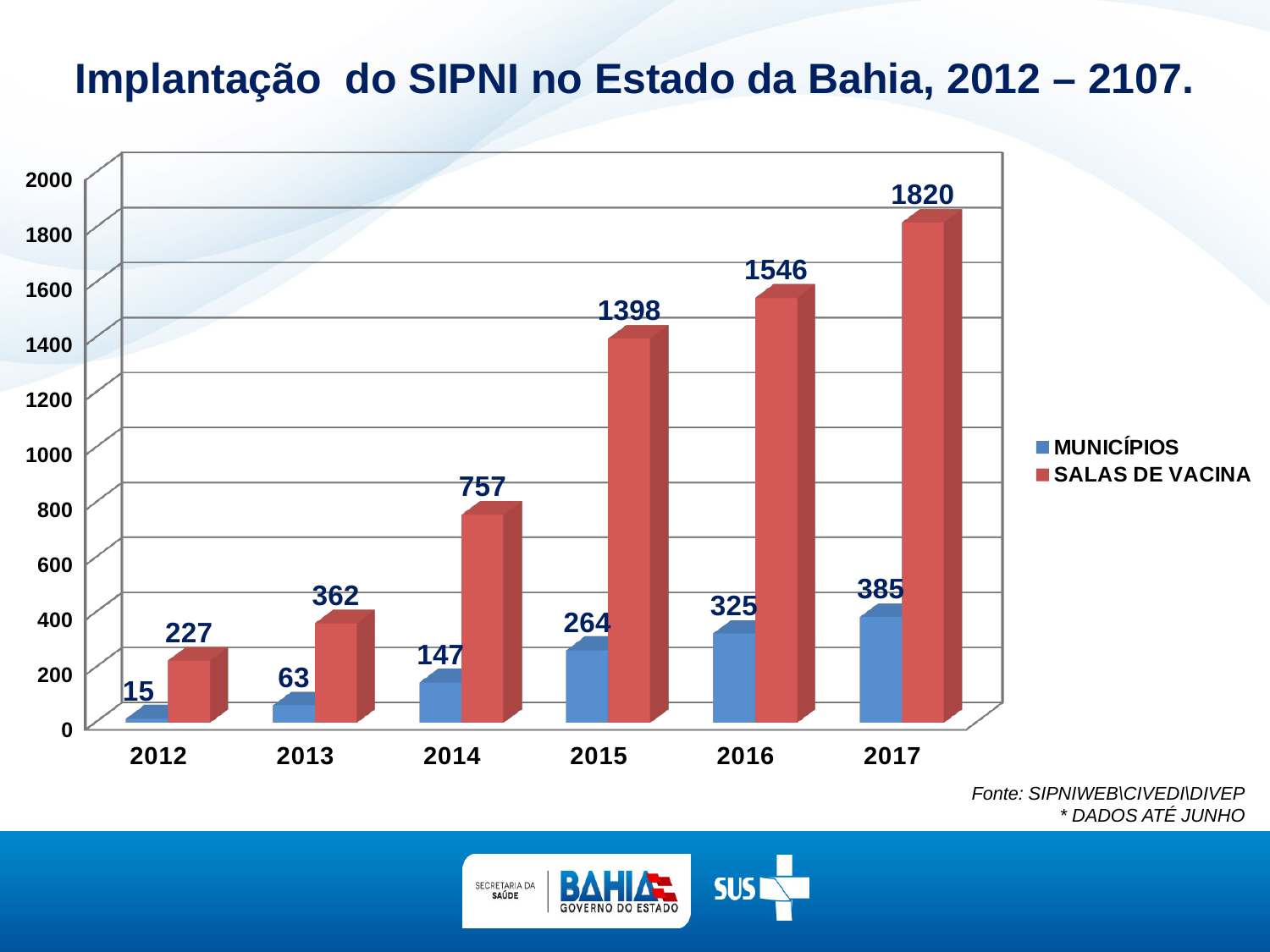
What is the value for SALAS DE VACINA in 2015? 1398 What is the value for MUNICÍPIOS in 2014? 147 What is the title of the chart? Implantação do SIPNI no Estado da Bahia, 2012 – 2107. Which year has the lowest value for MUNICÍPIOS? 2012 How many years are shown on the x axis? 6 How many series does the legend list? 2 What kind of chart is shown on the slide? bar chart What is the difference between SALAS DE VACINA in 2017 and in 2016? 274 Which is larger: MUNICÍPIOS in 2016 or MUNICÍPIOS in 2015? MUNICÍPIOS in 2016 Which year has the highest value for SALAS DE VACINA? 2017 Do the values for SALAS DE VACINA rise or fall from 2012 to 2017? rise Is the value for SALAS DE VACINA in 2014 greater or less than 600? greater